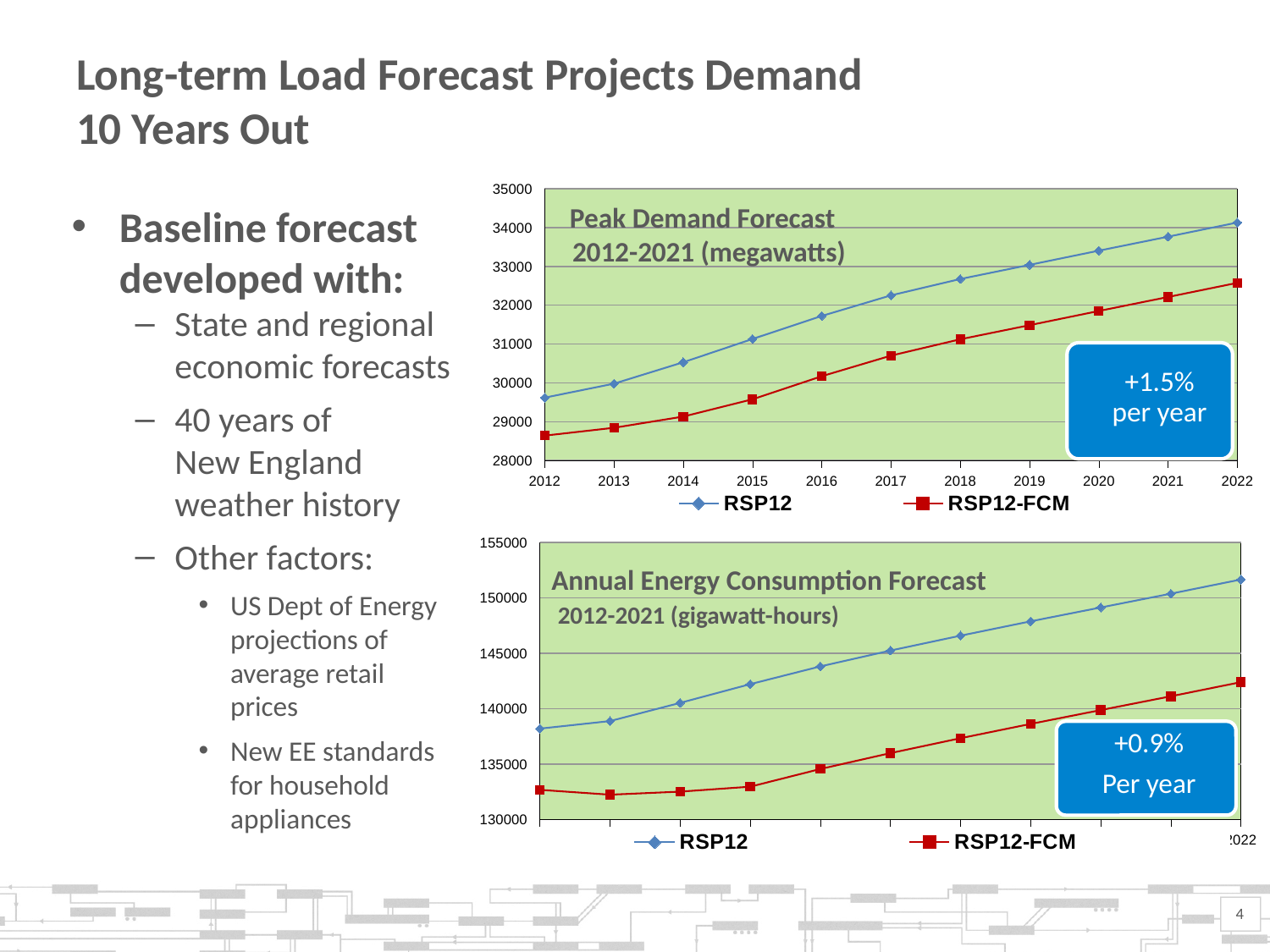
In the Peak Demand Forecast chart, is the RSP12 value for 2012 greater or less than 30000? less In the Peak Demand Forecast chart, is the RSP12-FCM value for 2012 greater or less than 29000? less What annual growth rate is shown in the callout on the Peak Demand Forecast chart? +1.5% per year In the Peak Demand Forecast chart, which series has the larger value in 2017, RSP12 or RSP12-FCM? RSP12 How many series does the legend of the Peak Demand Forecast chart list? 2 In the Annual Energy Consumption Forecast chart, is the first RSP12 value greater or less than 140000? less In the Annual Energy Consumption Forecast chart, do the RSP12-FCM values rise or fall over the last five points? rise In the Peak Demand Forecast chart, do the RSP12 values rise or fall from 2012 to 2022? rise In the Peak Demand Forecast chart, how many years are labelled on the x axis? 11 What unit is given in the title of the Annual Energy Consumption Forecast chart? gigawatt-hours What kind of chart is the Peak Demand Forecast chart? line chart